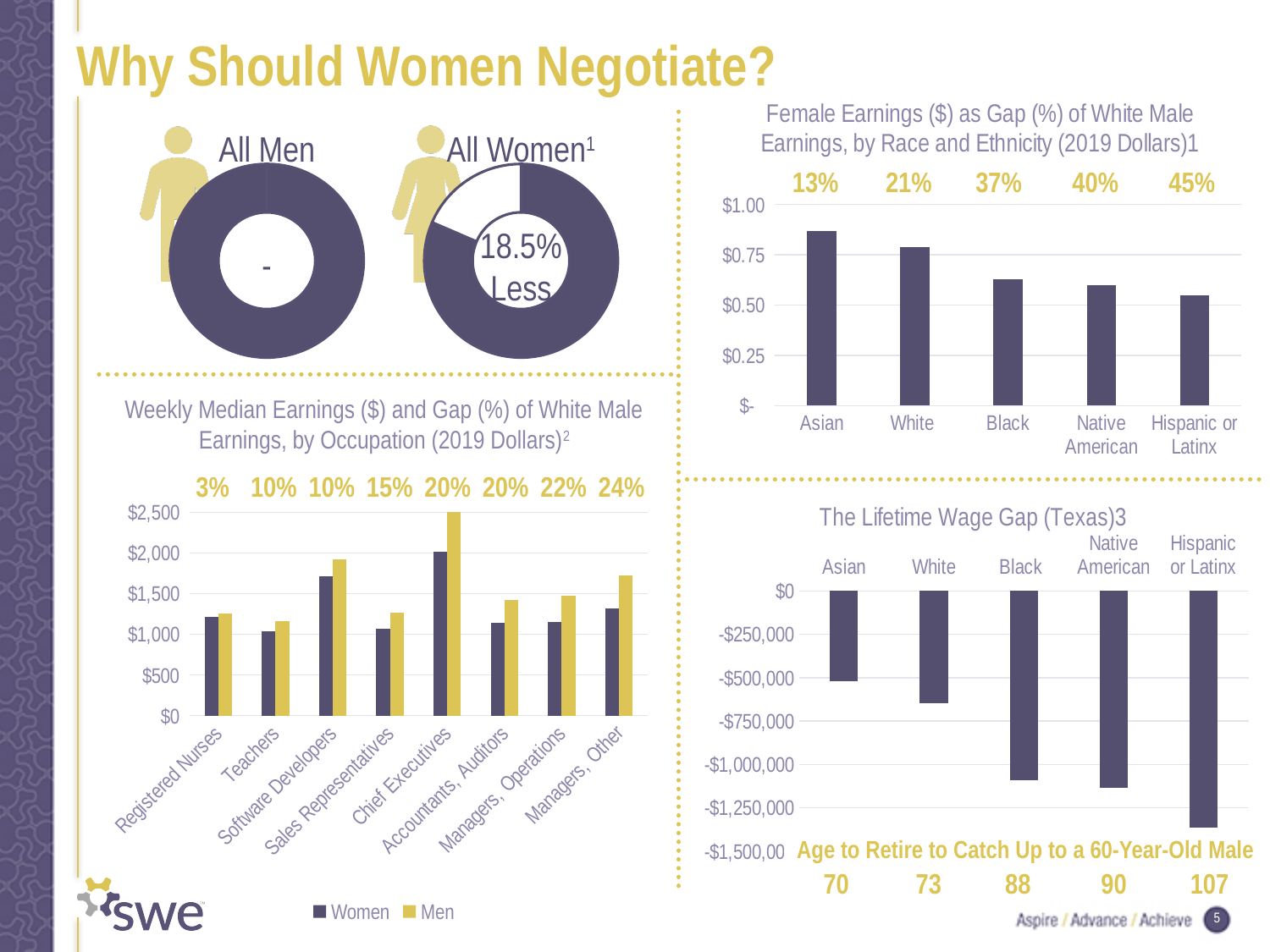
In the chart 'Weekly Median Earnings ($) and Gap (%) of White Male Earnings, by Occupation', which is larger for Software Developers, Women or Men? Men In the chart 'The Lifetime Wage Gap (Texas)', what is the age to retire to catch up to a 60-year-old male for Hispanic or Latinx? 107 In the chart 'Weekly Median Earnings ($) and Gap (%) of White Male Earnings, by Occupation', how many occupations are shown? 8 In the chart 'Female Earnings ($) as Gap (%) of White Male Earnings, by Race and Ethnicity', is the bar for Asian greater or less than $0.75? greater In the chart 'Weekly Median Earnings ($) and Gap (%) of White Male Earnings, by Occupation', what gap percentage is shown for Managers, Other? 24% In the chart 'Weekly Median Earnings ($) and Gap (%) of White Male Earnings, by Occupation', what gap percentage is shown for Registered Nurses? 3% In the chart 'Female Earnings ($) as Gap (%) of White Male Earnings, by Race and Ethnicity', how many race/ethnicity categories are shown? 5 In the chart 'Weekly Median Earnings ($) and Gap (%) of White Male Earnings, by Occupation', is the Men value for Chief Executives greater or less than $2,000? greater In the chart 'The Lifetime Wage Gap (Texas)', what is the difference between the retirement ages shown for Hispanic or Latinx and Asian? 37 In the chart 'Weekly Median Earnings ($) and Gap (%) of White Male Earnings, by Occupation', how many series does the legend list? 2 In the chart 'Female Earnings ($) as Gap (%) of White Male Earnings, by Race and Ethnicity', which group has the highest gap percentage? Hispanic or Latinx In the chart 'Female Earnings ($) as Gap (%) of White Male Earnings, by Race and Ethnicity', what gap percentage is shown for Black? 37%